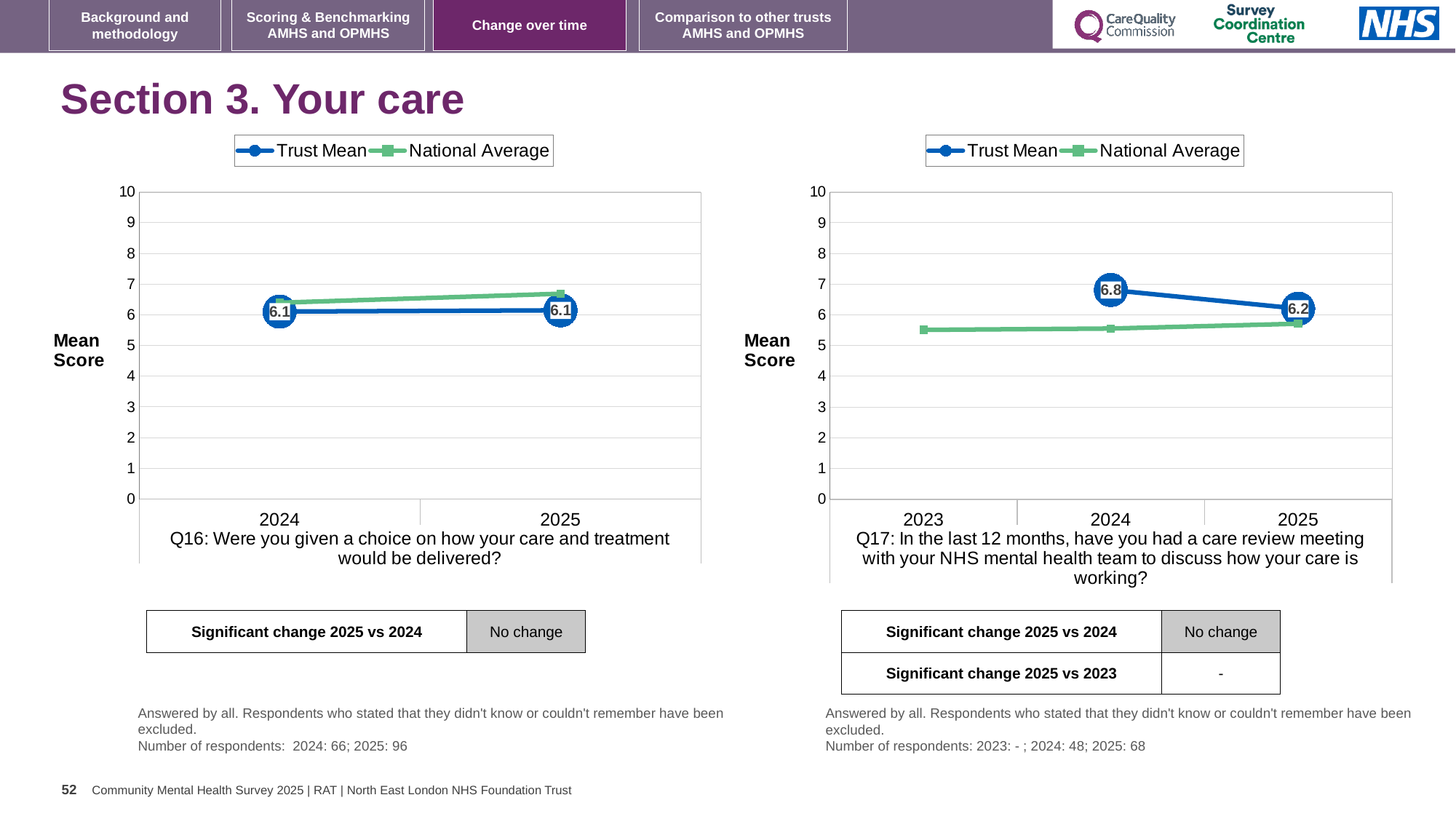
How many series does the legend of the Q16 chart (left) list? 2 On the Q17 chart (right), is the National Average for 2024 greater or less than 6? less On the Q16 chart (left), what is the Trust Mean for 2025? 6.1 On the Q16 chart (left), is the National Average for 2025 greater or less than 6? greater On the Q17 chart (right), what is the difference between the Trust Mean for 2024 and the Trust Mean for 2025? 0.6 On the Q17 chart (right), what is the Trust Mean for 2025? 6.2 On the Q17 chart (right), which year has the higher Trust Mean, 2024 or 2025? 2024 On the Q16 chart (left), what is the Trust Mean for 2024? 6.1 On the Q17 chart (right), what is the Trust Mean for 2024? 6.8 On the Q17 chart (right), does the Trust Mean rise or fall from 2024 to 2025? fall How many years are shown on the x axis of the Q17 chart (right)? 3 What kind of chart is the Q16 chart (left)? line chart